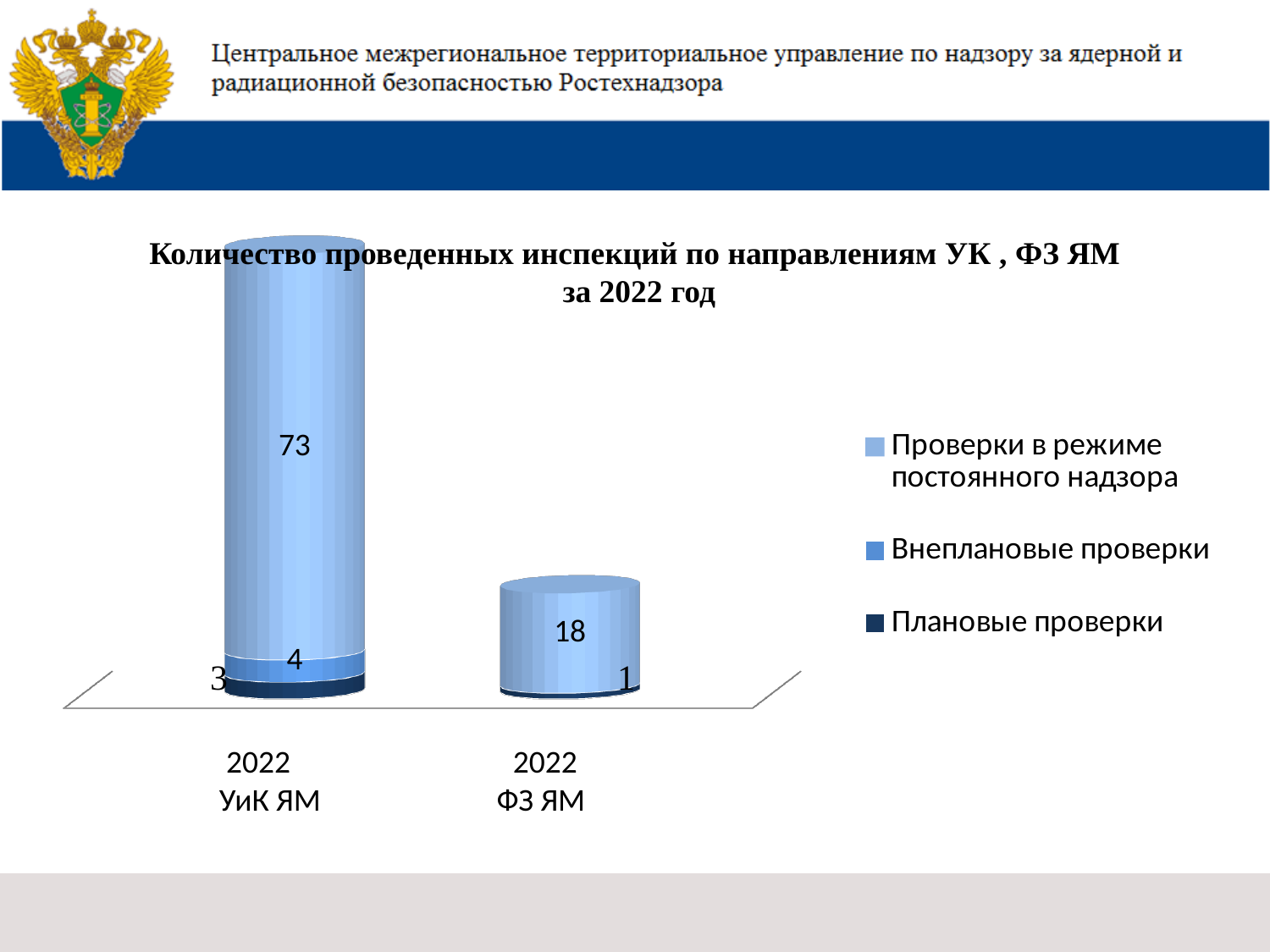
Which category has the higher value for Проверки в режиме постоянного надзора? 2022 УиК ЯМ How many categories are shown on the x axis? 2 What is the difference between the Проверки в режиме постоянного надзора values for 2022 УиК ЯМ and 2022 ФЗ ЯМ? 55 What is the value of Проверки в режиме постоянного надзора for 2022 УиК ЯМ? 73 Which series is shown in the darkest blue colour in the legend? Плановые проверки What is the value of Внеплановые проверки for 2022 УиК ЯМ? 4 What type of chart is shown on the slide? Bar chart How many series does the legend list? 3 What is the value of Проверки в режиме постоянного надзора for 2022 ФЗ ЯМ? 18 What is the title of the chart? Количество проведенных инспекций по направлениям УК , ФЗ ЯМ за 2022 год What is the value of Плановые проверки for 2022 УиК ЯМ? 3 What is the total of the stacked bar for 2022 УиК ЯМ? 80